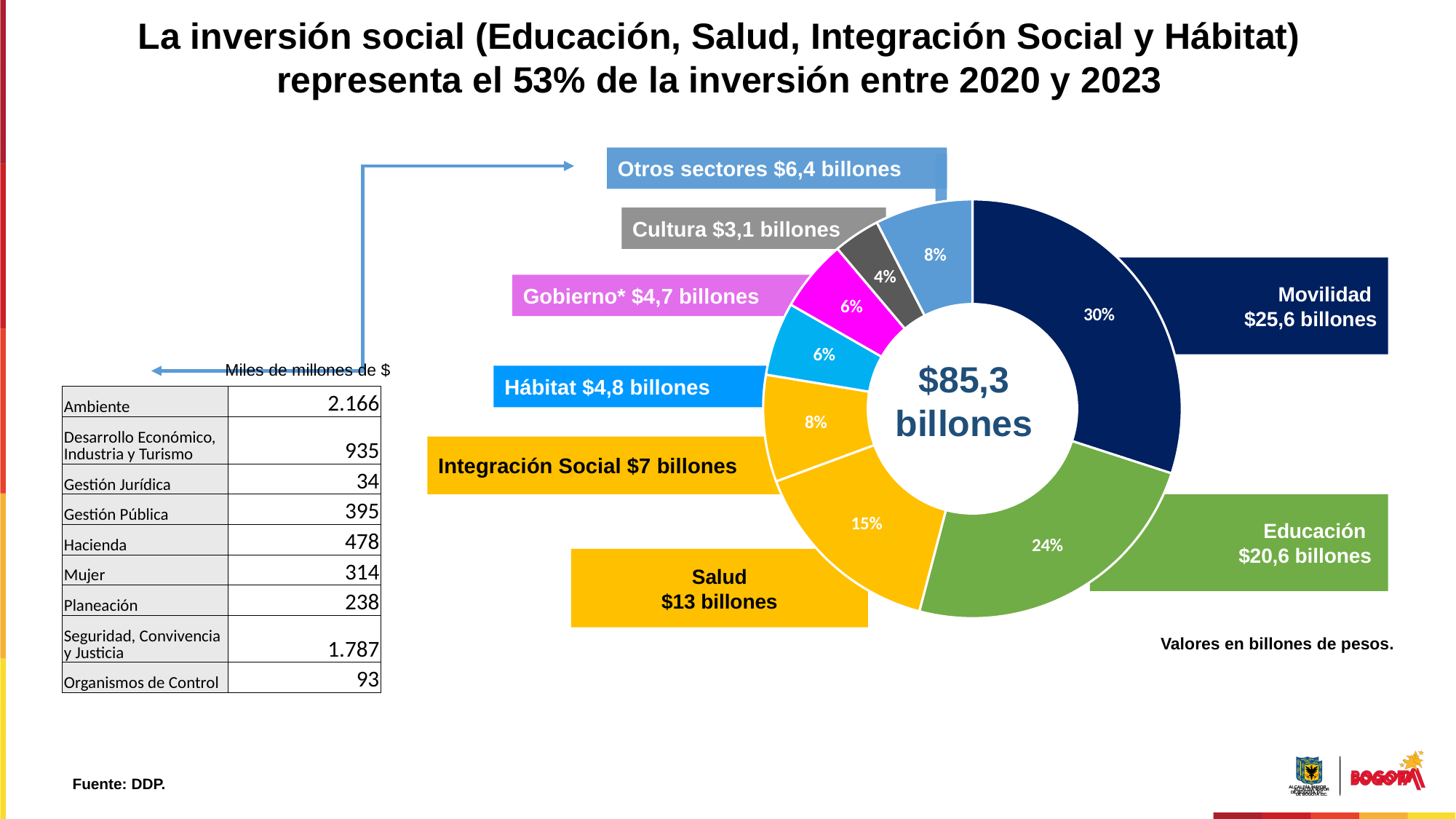
Which sector has the smallest share in the donut chart? Cultura What percentage share of the donut chart does Educación represent? 24% What percentage share does Salud represent in the donut chart? 15% Which sector has the largest share in the donut chart? Movilidad What colour is the Movilidad segment of the donut chart? Dark navy blue Which is larger, the value for Salud or the value for Integración Social? Salud What kind of chart is shown on the slide? Donut (pie) chart What is the value shown for Hábitat in the donut chart? $4,8 billones What is the value shown for Movilidad in the donut chart? $25,6 billones How many sectors are shown in the donut chart? 8 What is the total value shown in the centre of the donut chart? $85,3 billones What is the difference in billones between Movilidad and Educación? $5 billones